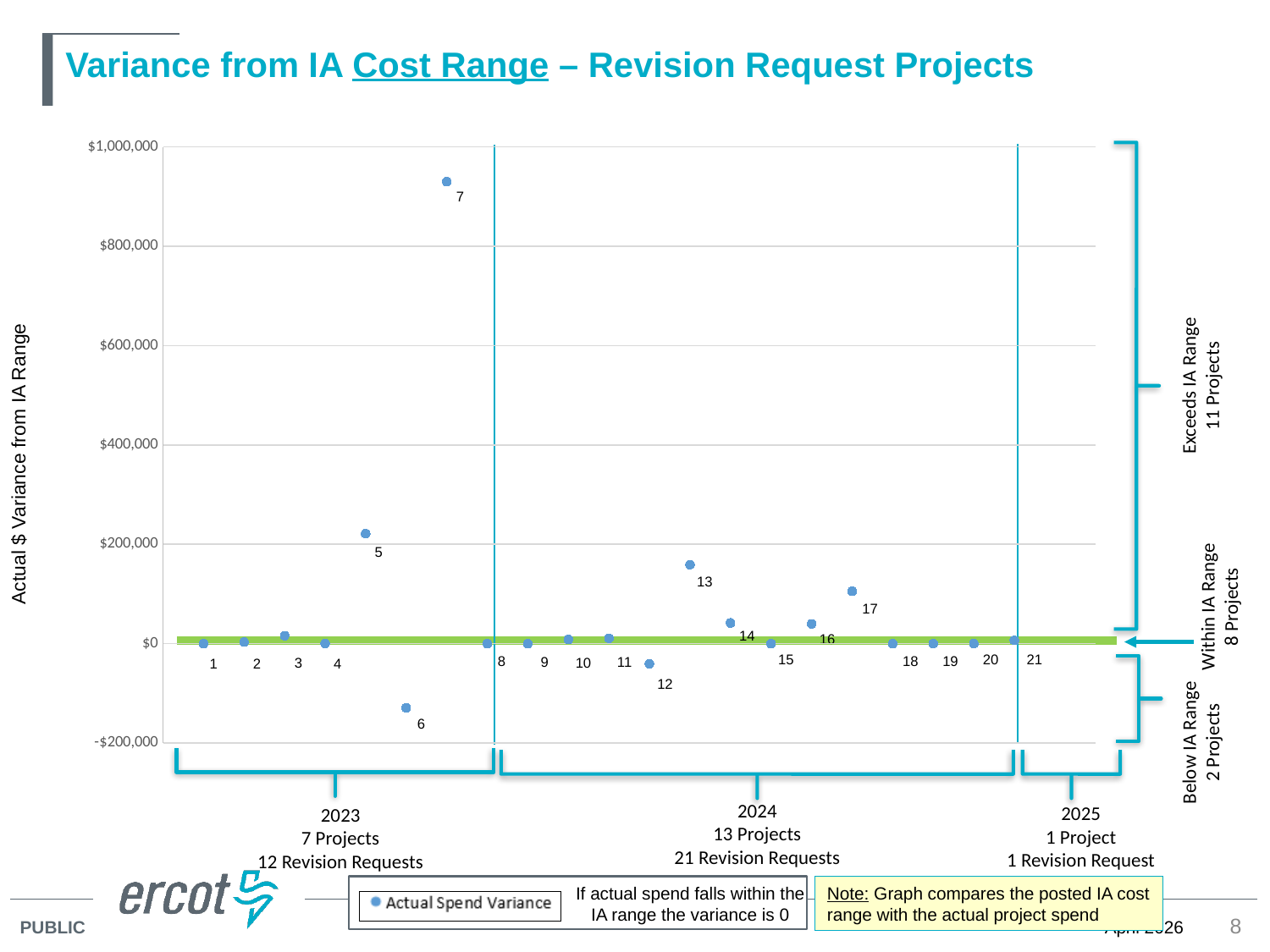
What kind of chart is shown on the slide? Scatter chart Is the value for project 6 greater or less than $0? less Which has the larger variance, project 13 or project 17? Project 13 How many series does the legend list? 1 Is the value for project 13 greater or less than $200,000? less Is the value for project 5 greater or less than $200,000? greater Which numbered project has the highest actual $ variance from IA range? 7 What is the series name shown in the legend? Actual Spend Variance How many data points are plotted on the chart? 21 Which numbered project has the lowest actual $ variance from IA range? 6 What is the label of the y axis? Actual $ Variance from IA Range